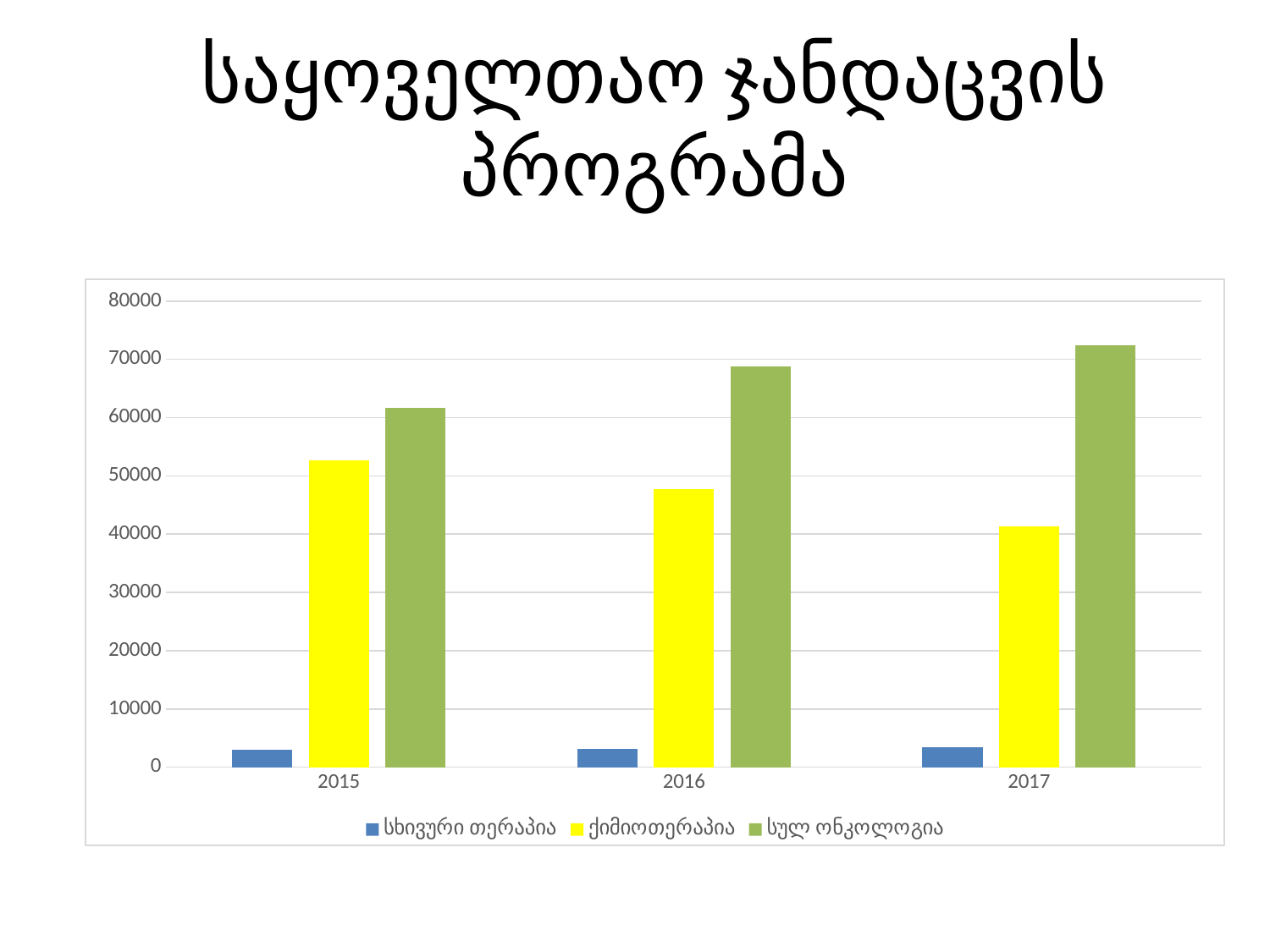
Is the value for ქიმიოთერაპია in 2017 greater or less than 50000? less Which colour represents სხივური თერაპია in the chart? blue Is the value for ქიმიოთერაპია in 2015 greater or less than 50000? greater Which year has the highest value for სულ ონკოლოგია? 2017 What kind of chart is shown on the slide? bar chart Which is larger in 2016: ქიმიოთერაპია or სულ ონკოლოგია? სულ ონკოლოგია How many series does the chart legend list? 3 How many years are shown on the x axis of the chart? 3 Is the value for სხივური თერაპია in 2016 greater or less than 10000? less Do the values for ქიმიოთერაპია rise or fall from 2015 to 2017? fall Which year has the lowest value for ქიმიოთერაპია? 2017